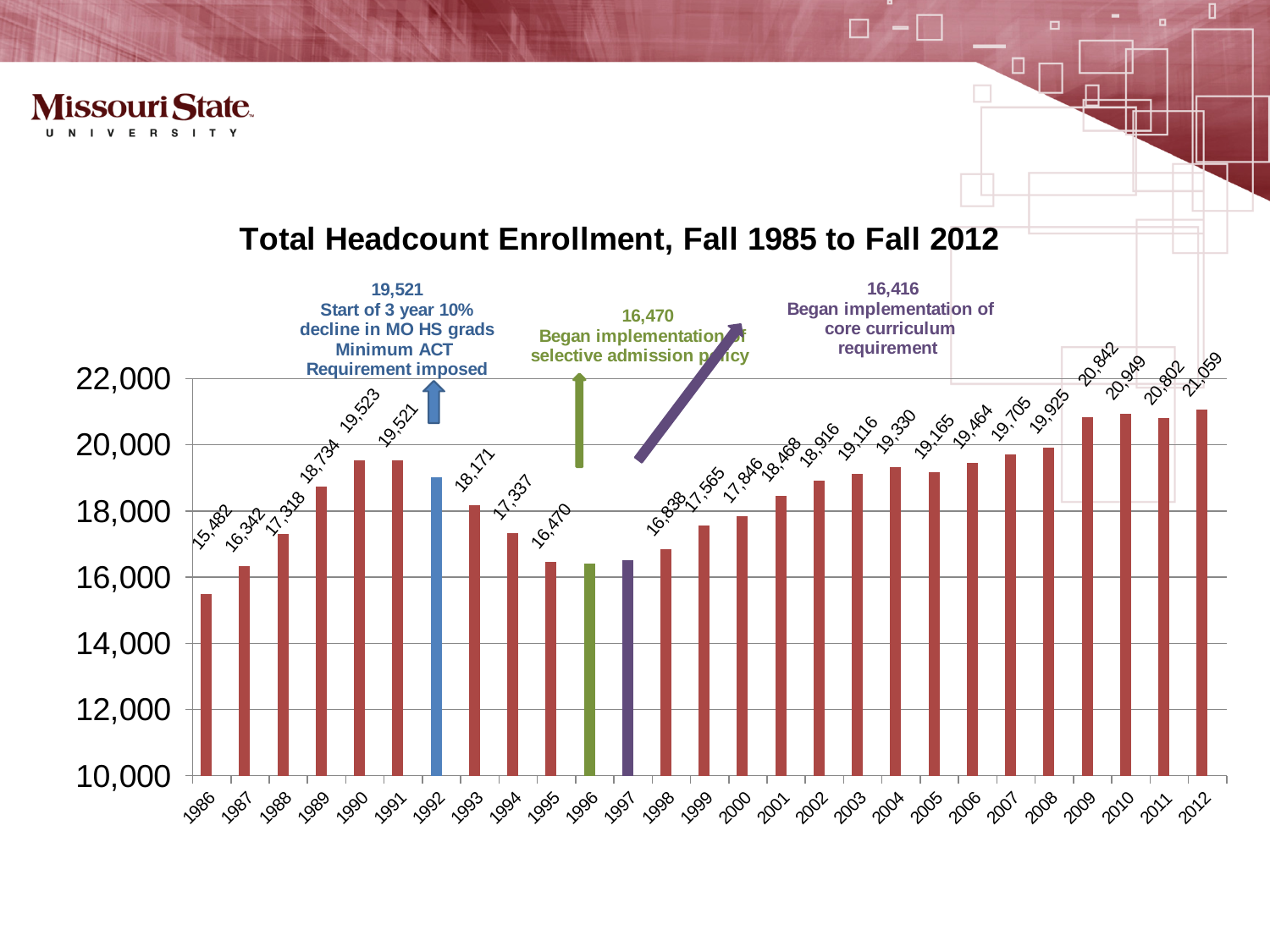
What is the total headcount enrollment for 2000? 17,846 Which year has the highest total headcount enrollment? 2012 How many years (bars) are shown on the chart? 27 What is the total headcount enrollment for 2008? 19,925 What kind of chart is shown on the slide? Bar chart Which year had higher enrollment, 2010 or 2011? 2010 Which year has the lowest total headcount enrollment? 1986 What is the title of the chart? Total Headcount Enrollment, Fall 1985 to Fall 2012 What is the total headcount enrollment for 2012? 21,059 What is the difference in enrollment between 2012 and 1986? 5,577 Is the enrollment value for 1986 greater or less than 16,000? less What is the total headcount enrollment for 1986? 15,482